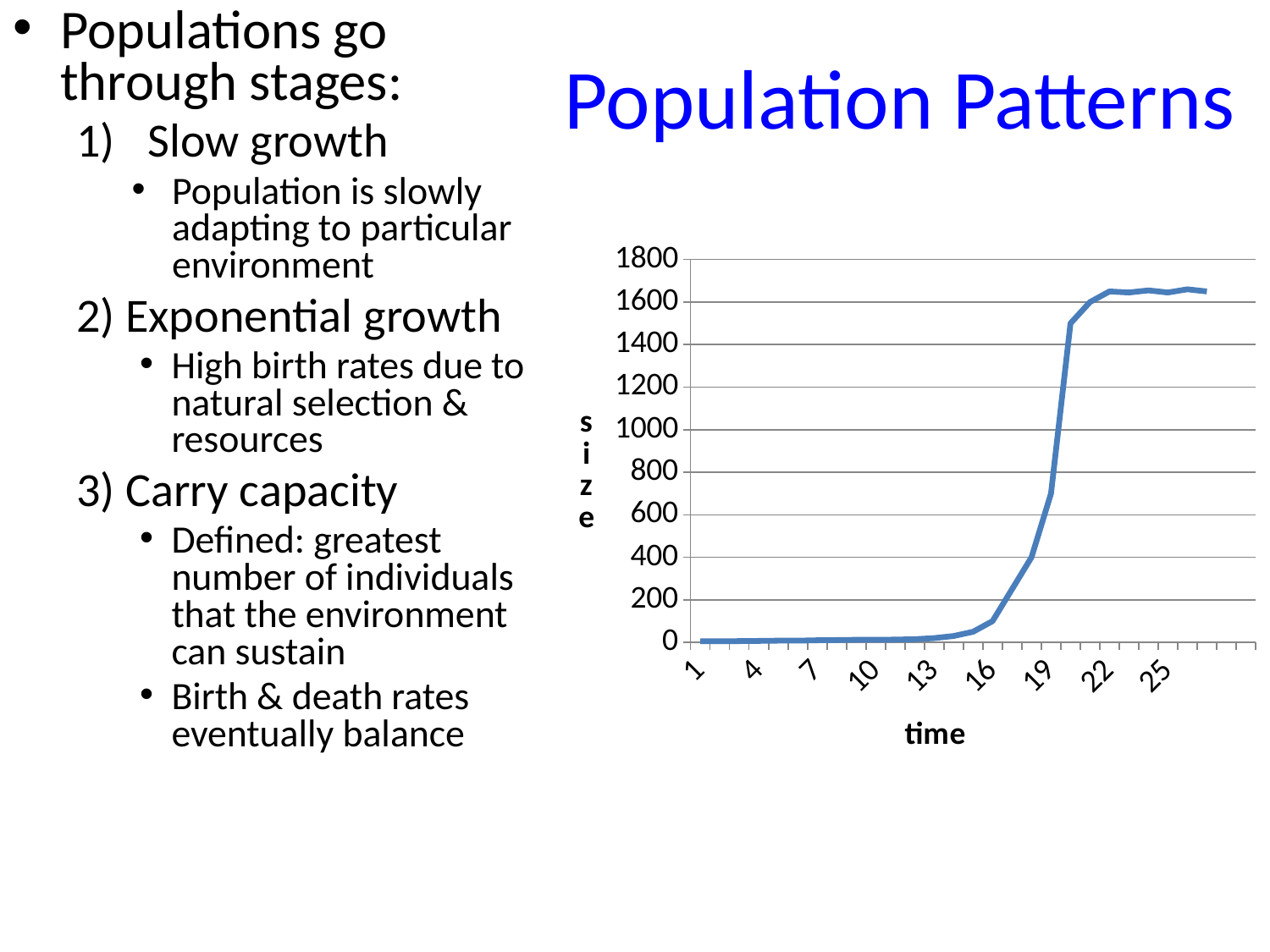
What kind of chart is shown on the slide? line chart Is the value for time 19 greater or less than 1000? less What is the label of the x axis of the chart? time Do the values on the chart generally rise or fall as time increases? rise Is the value for time 13 greater or less than 200? less What is the highest value shown on the y axis of the chart? 1800 What is the label of the y axis of the chart? size Is the value for time 19 greater or less than 400? greater Which is larger, the value at time 10 or the value at time 22? time 22